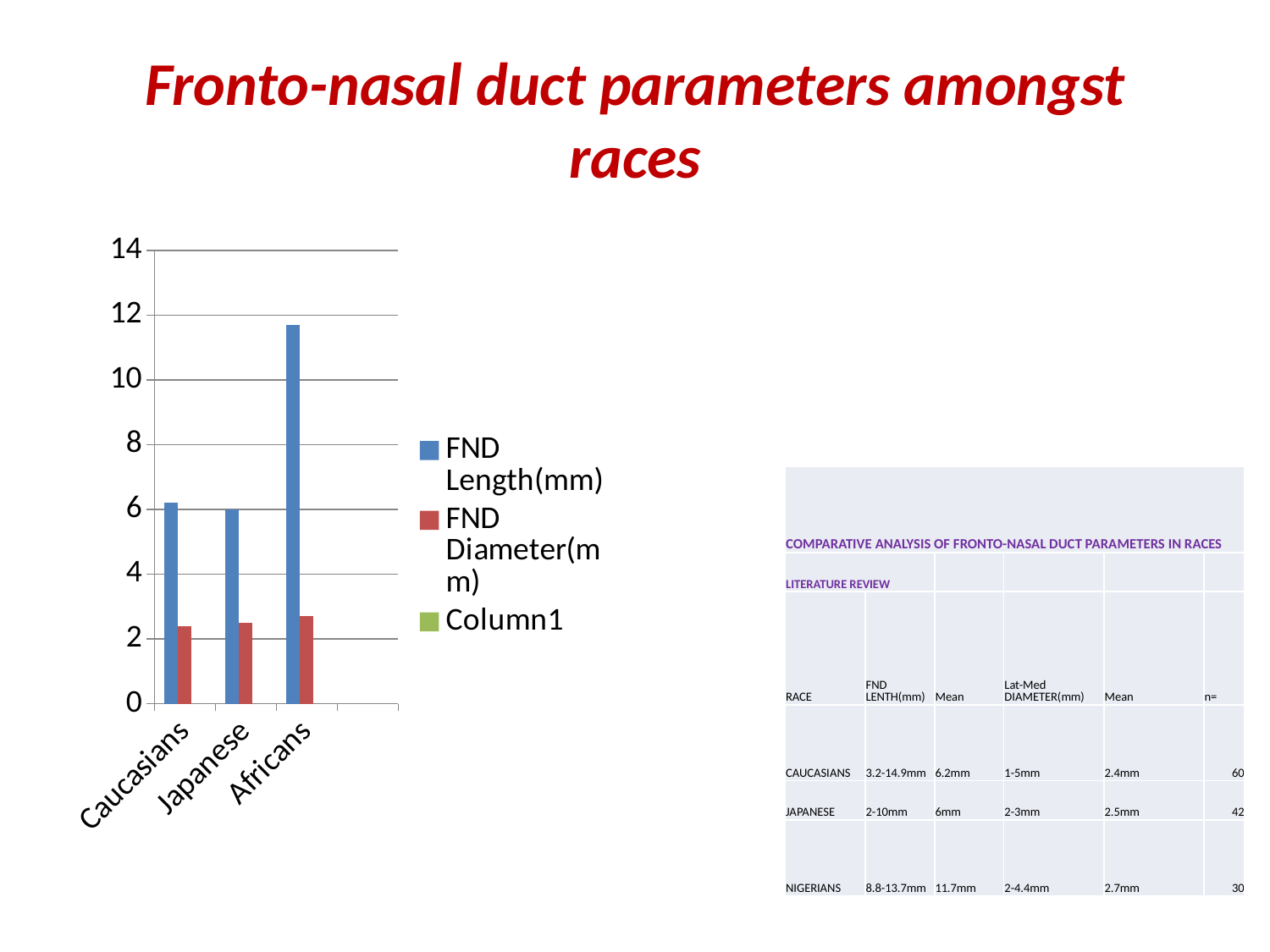
Is the FND Diameter(mm) value for Caucasians greater or less than 2? greater What kind of chart is shown on the slide? bar chart How many series does the chart legend list? 3 Which category has the highest FND Length(mm) value in the chart? Africans Which is larger for Japanese, the FND Length(mm) value or the FND Diameter(mm) value? FND Length(mm) Is the FND Length(mm) value for Caucasians greater or less than 8? less Is the FND Length(mm) value for Africans greater or less than 10? greater What colour are the FND Length(mm) bars in the chart? blue What is the name of the third legend entry in the chart? Column1 Which is larger, the FND Length(mm) value for Africans or for Caucasians? Africans How many categories are shown on the x axis of the chart? 3